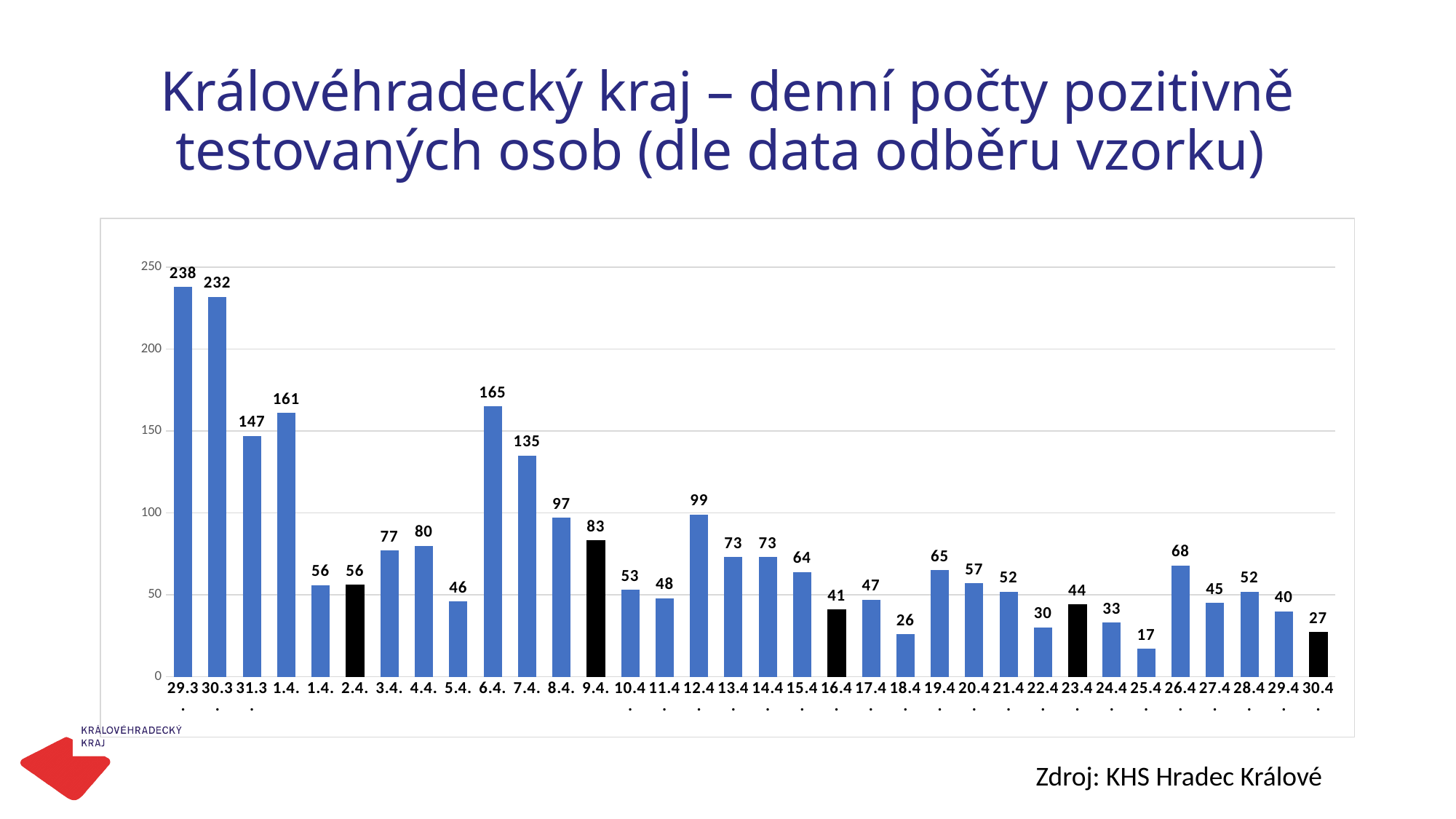
Is the value for 26.4 greater or less than 50? greater Which date has the highest value? 29.3 What kind of chart is shown on the slide? bar chart How many bars are plotted in the chart? 34 What is the value for 19.4? 65 What is the value for 6.4.? 165 Which date has the lowest value? 25.4 What is the difference between the values for 29.3 and 30.3? 6 Do the values generally rise or fall from left to right along the x axis? fall What is the difference between the values for 6.4. and 7.4.? 30 What is the value for 12.4? 99 Which is larger, the value for 7.4. or the value for 8.4.? 7.4.